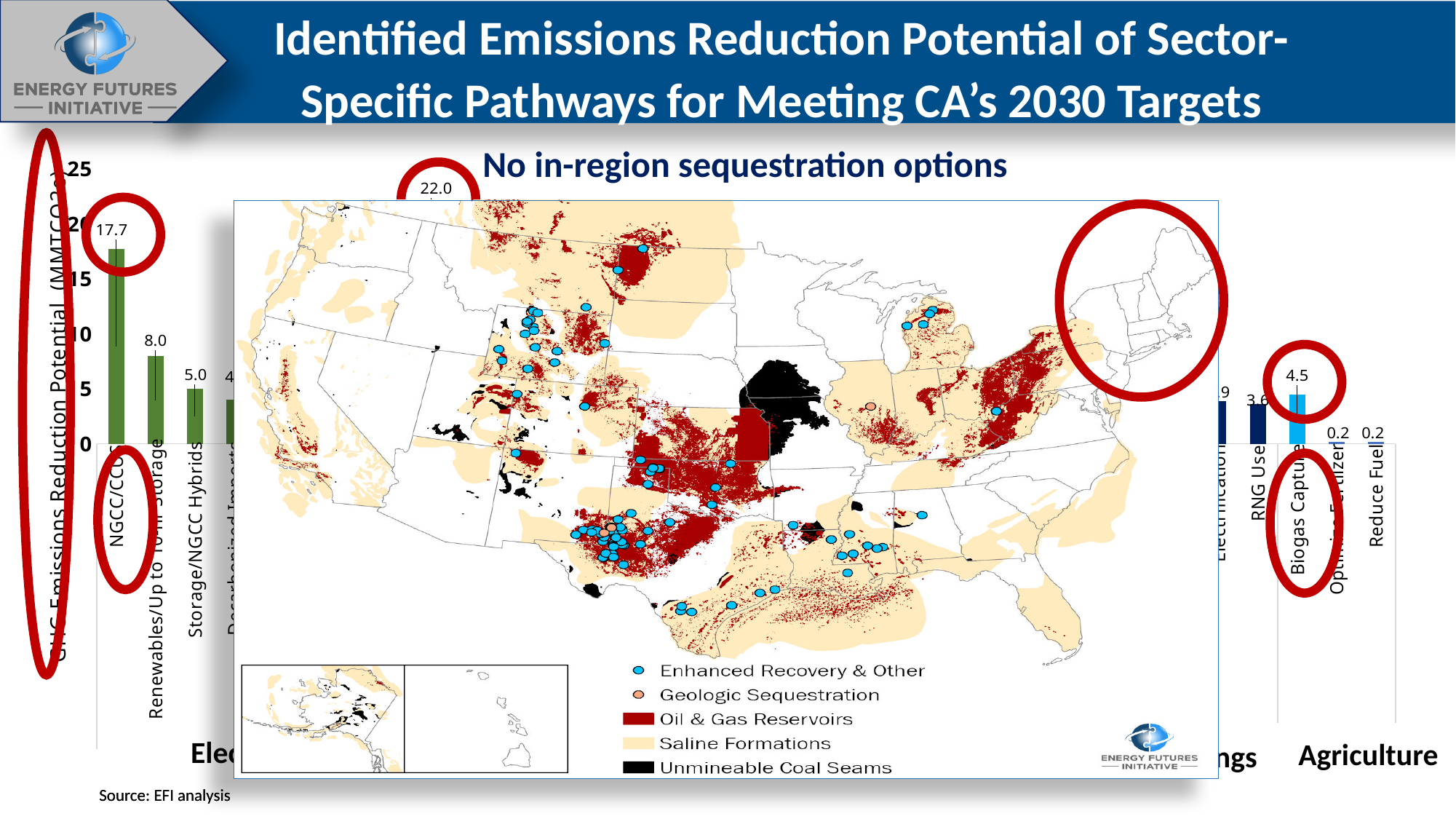
What is the value for Renewables/Up to 10 hr Storage in the bar chart? 8.0 Is the value for NGCC/CCS greater or less than 15? greater What is the value for NGCC/CCS in the bar chart? 17.7 What is the label of the vertical axis of the bar chart? GHG Emissions Reduction Potential (MMTCO2e) What is the difference between the values for Storage/NGCC Hybrids and Biogas Capture? 0.5 What is the value for Biogas Capture in the bar chart? 4.5 What kind of chart is shown behind the map on the slide? bar chart What is the difference between the values for NGCC/CCS and Renewables/Up to 10 hr Storage? 9.7 Which is larger, the value for Biogas Capture or the value for RNG Use? Biogas Capture What is the value for Reduce Fuel in the bar chart? 0.2 What is the value for RNG Use in the bar chart? 3.6 What is the value for Storage/NGCC Hybrids in the bar chart? 5.0